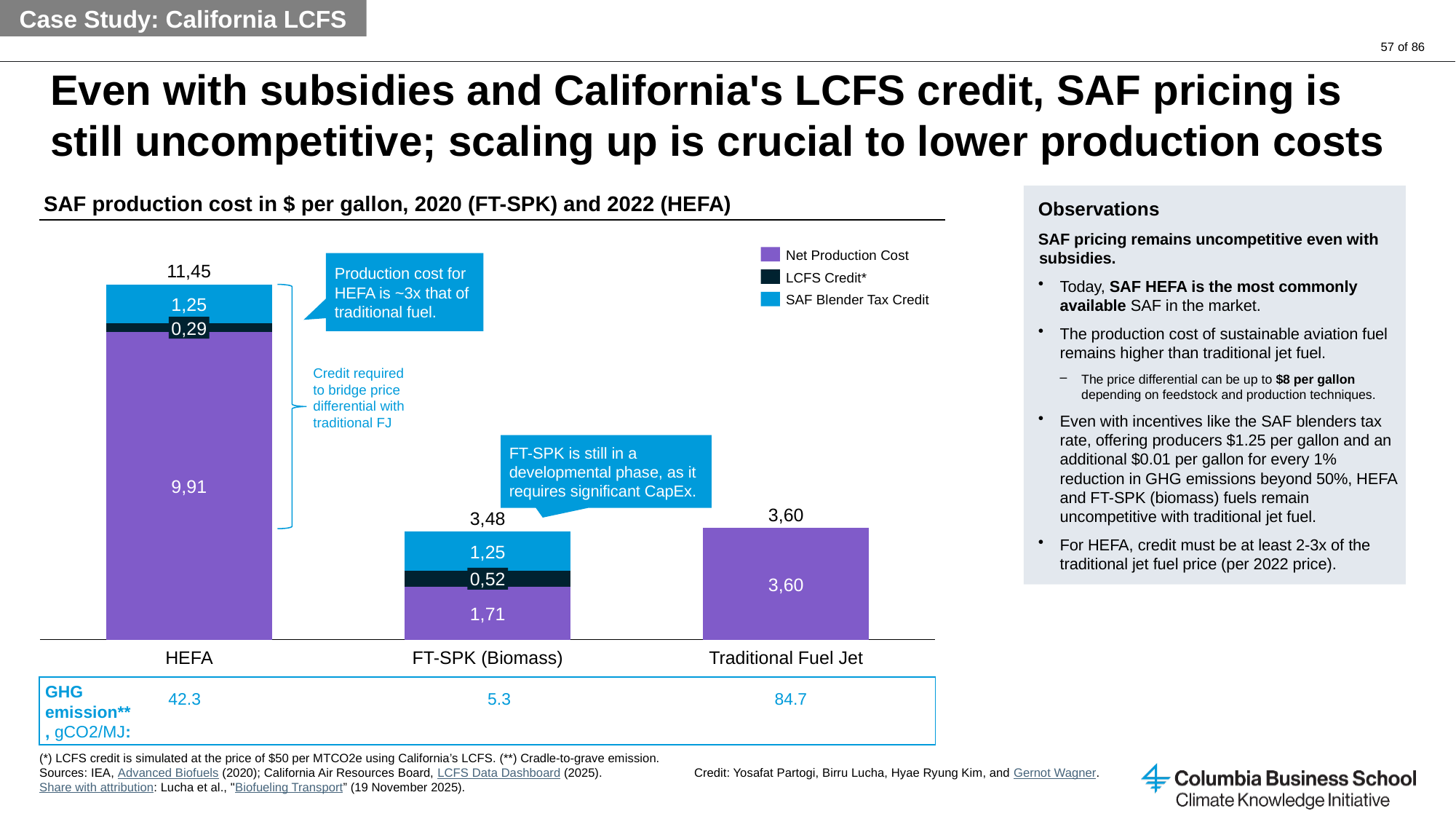
Which category has the highest total production cost? HEFA What is the SAF Blender Tax Credit value for FT-SPK (Biomass)? 1,25 What is the title of the chart? SAF production cost in $ per gallon, 2020 (FT-SPK) and 2022 (HEFA) What is the total SAF production cost shown for HEFA? 11,45 What is the Net Production Cost value for FT-SPK (Biomass)? 1,71 How many series does the chart legend list? 3 How many categories are shown on the x axis of the chart? 3 Which is larger: the LCFS Credit* for HEFA or for FT-SPK (Biomass)? FT-SPK (Biomass) Which category has the lowest total production cost? FT-SPK (Biomass) What kind of chart is shown on the slide? Stacked bar chart What is the difference between the Net Production Cost for HEFA and for FT-SPK (Biomass)? 8,20 What is the LCFS Credit* value for HEFA? 0,29